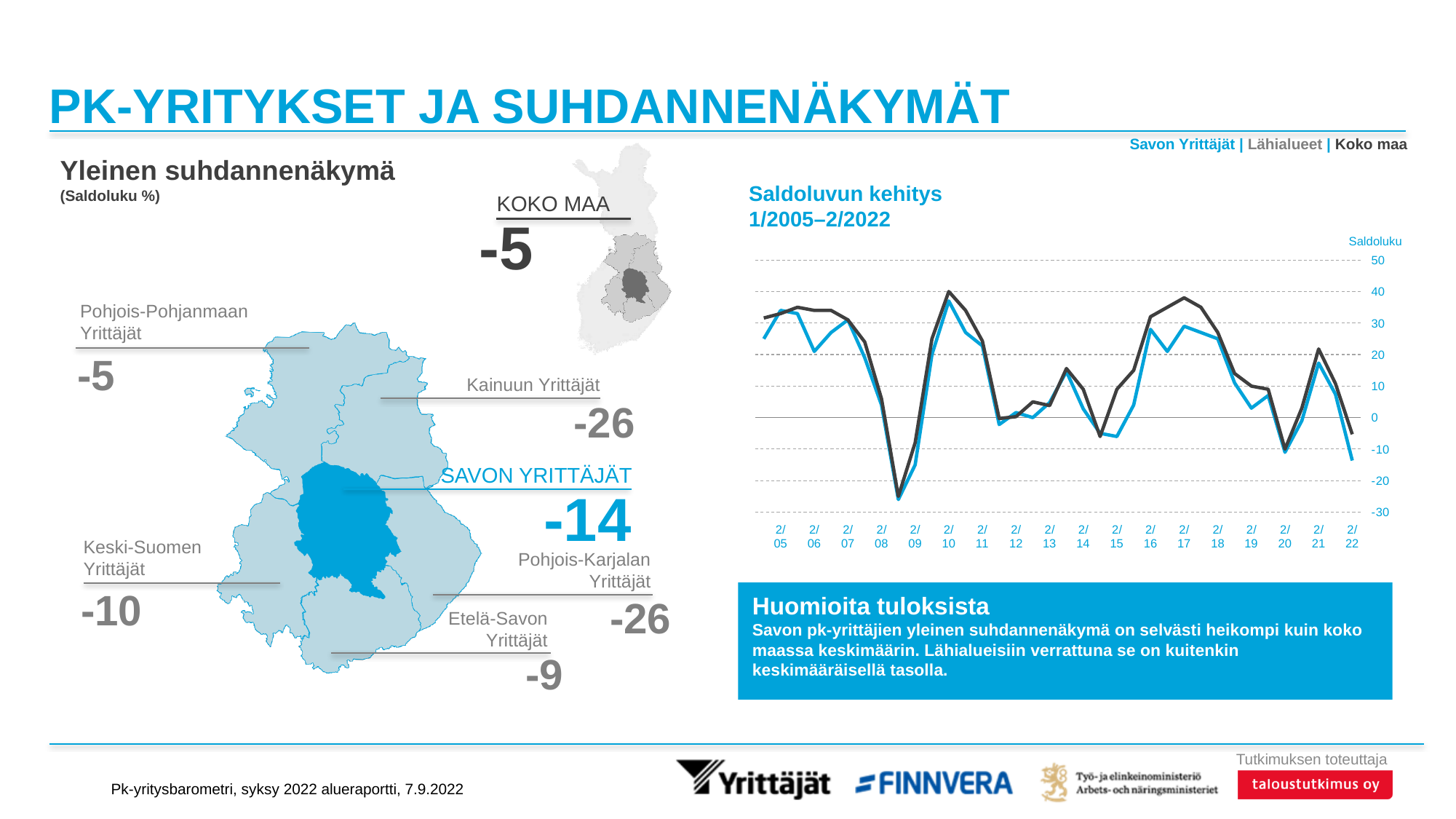
On the map 'Yleinen suhdannenäkymä', what is the value for Savon Yrittäjät? -14 On the map 'Yleinen suhdannenäkymä', which regional association (excluding Koko maa) has the highest value? Pohjois-Pohjanmaan Yrittäjät In the chart 'Saldoluvun kehitys 1/2005–2/2022', how many labelled points are on the x axis? 18 In the chart 'Saldoluvun kehitys 1/2005–2/2022', is the value of the dark Koko maa line at 2/10 greater or less than 30? greater In the chart 'Saldoluvun kehitys 1/2005–2/2022', do the lines rise or fall between 2/21 and 2/22? fall In the chart 'Saldoluvun kehitys 1/2005–2/2022', is the value of the blue Savon Yrittäjät line at 2/22 greater or less than 0? less What kind of chart is 'Saldoluvun kehitys 1/2005–2/2022'? line chart On the map 'Yleinen suhdannenäkymä', which has the higher value, Keski-Suomen Yrittäjät or Etelä-Savon Yrittäjät? Etelä-Savon Yrittäjät On the map 'Yleinen suhdannenäkymä', what is the value for Koko maa? -5 On the map 'Yleinen suhdannenäkymä', what is the value for Kainuun Yrittäjät? -26 On the map 'Yleinen suhdannenäkymä', what is the difference between the Koko maa value and the Savon Yrittäjät value? 9 On the map 'Yleinen suhdannenäkymä', what is the value for Etelä-Savon Yrittäjät? -9